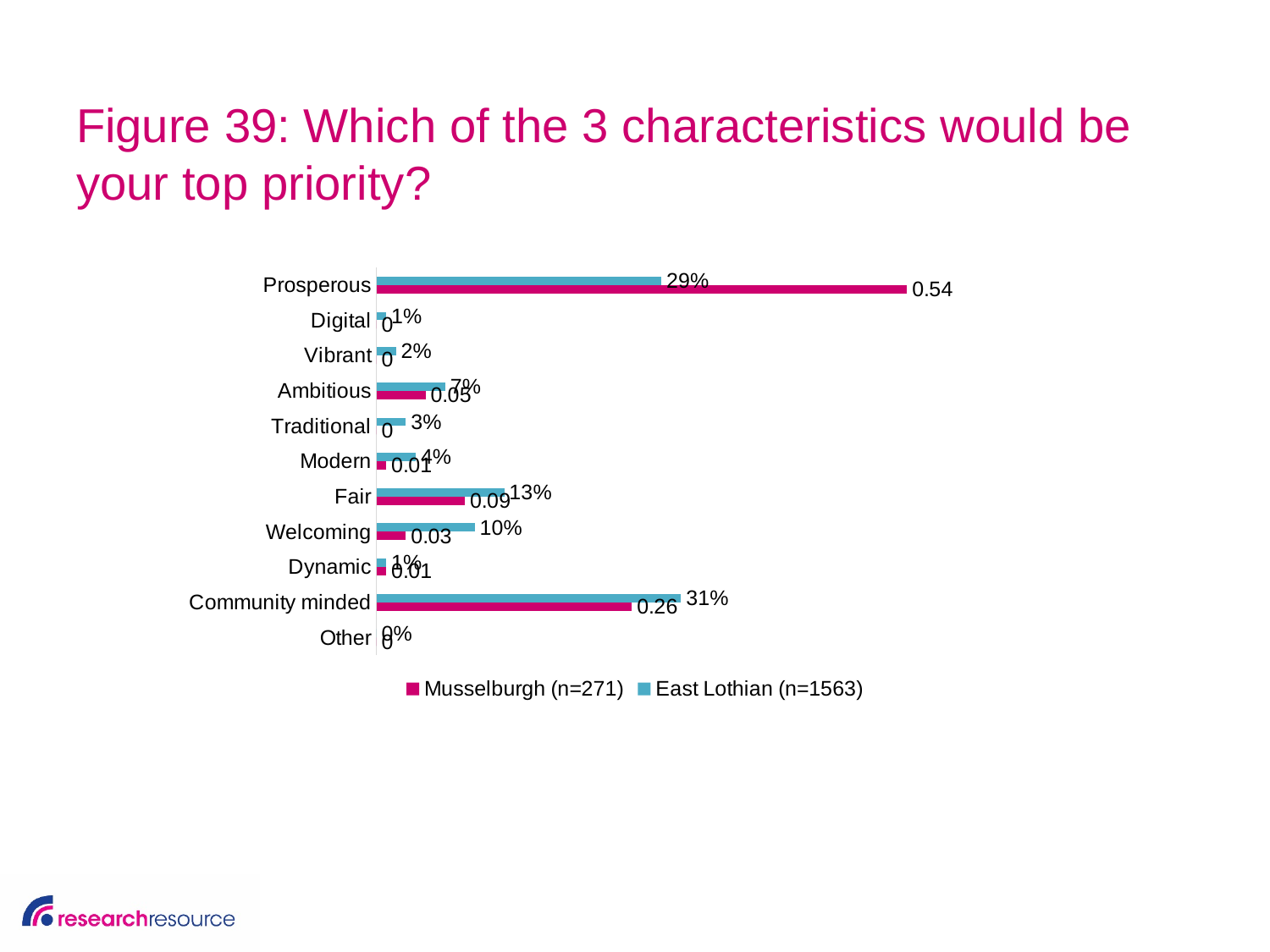
What is the difference between the East Lothian (n=1563) values for Fair and Welcoming? 3% What kind of chart is shown on the slide? bar chart Which characteristic has the highest Musselburgh (n=271) value? Prosperous How many characteristics (categories) are plotted on the chart? 11 What is the East Lothian (n=1563) value for Prosperous? 29% What is the Musselburgh (n=271) value for Prosperous? 0.54 How many series does the legend list? 2 What is the Musselburgh (n=271) value for Fair? 0.09 Which characteristic has the highest East Lothian (n=1563) value? Community minded What is the East Lothian (n=1563) value for Community minded? 31% For Prosperous, which series has the larger value, Musselburgh (n=271) or East Lothian (n=1563)? Musselburgh (n=271) What is the East Lothian (n=1563) value for Welcoming? 10%